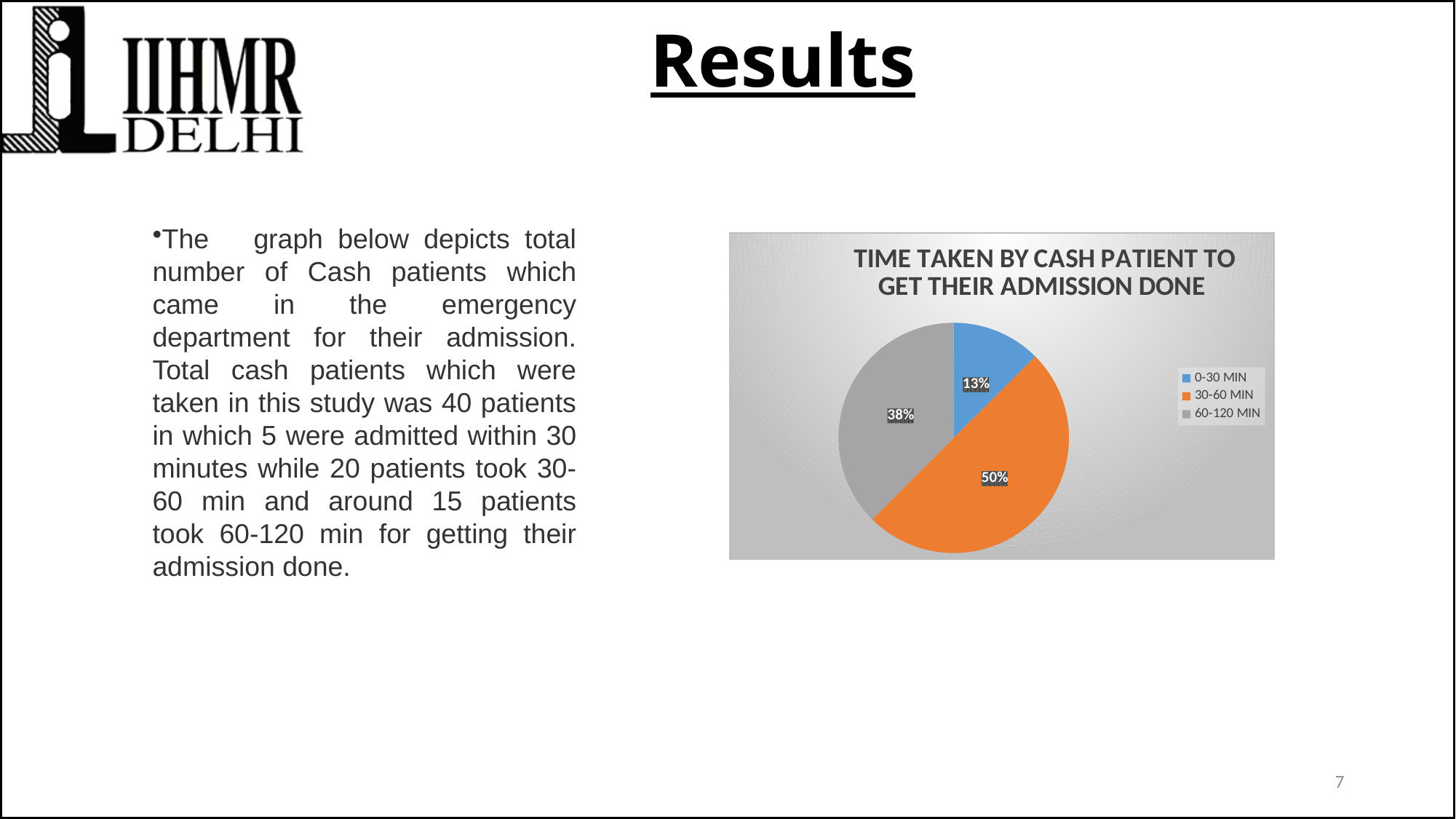
How many categories does the legend list? 3 What kind of chart is shown on the slide? Pie chart What share of the pie does the 60-120 MIN slice represent? 38% What is the difference in percentage points between the 60-120 MIN slice and the 0-30 MIN slice? 25 What share of the pie does the 30-60 MIN slice represent? 50% What share of the pie does the 0-30 MIN slice represent? 13% What colour is the 30-60 MIN slice? Orange Which category has the smallest slice of the pie? 0-30 MIN Which category has the largest slice of the pie? 30-60 MIN What is the title of the chart? TIME TAKEN BY CASH PATIENT TO GET THEIR ADMISSION DONE Which is larger, the 60-120 MIN slice or the 0-30 MIN slice? 60-120 MIN What is the difference in percentage points between the 30-60 MIN slice and the 0-30 MIN slice? 37